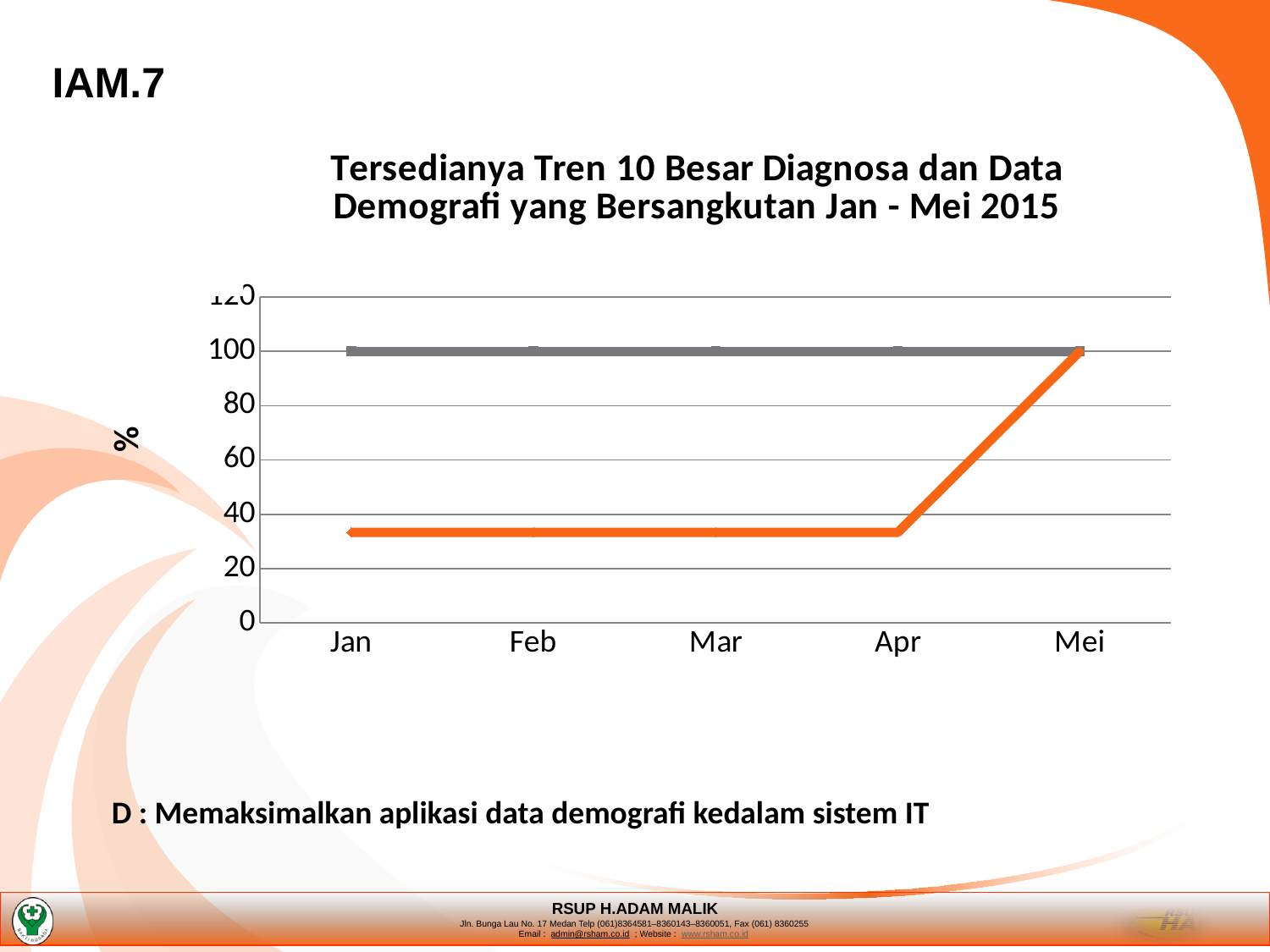
What is the value of the orange line in Mei? 100 What label is shown on the vertical axis of the chart? % Which month has the highest value on the orange line? Mei Is the value of the orange line in Jan greater or less than 40? less What is the value of the gray line in Mar? 100 What is the title of the chart? Tersedianya Tren 10 Besar Diagnosa dan Data Demografi yang Bersangkutan Jan - Mei 2015 Does the orange line rise or fall between Apr and Mei? rise What kind of chart is shown on the slide? line chart How many months are shown on the x axis of the chart? 5 Is the value of the orange line in Apr greater or less than 20? greater Which is larger in Feb, the gray line or the orange line? the gray line What is the value of the gray line in Jan? 100